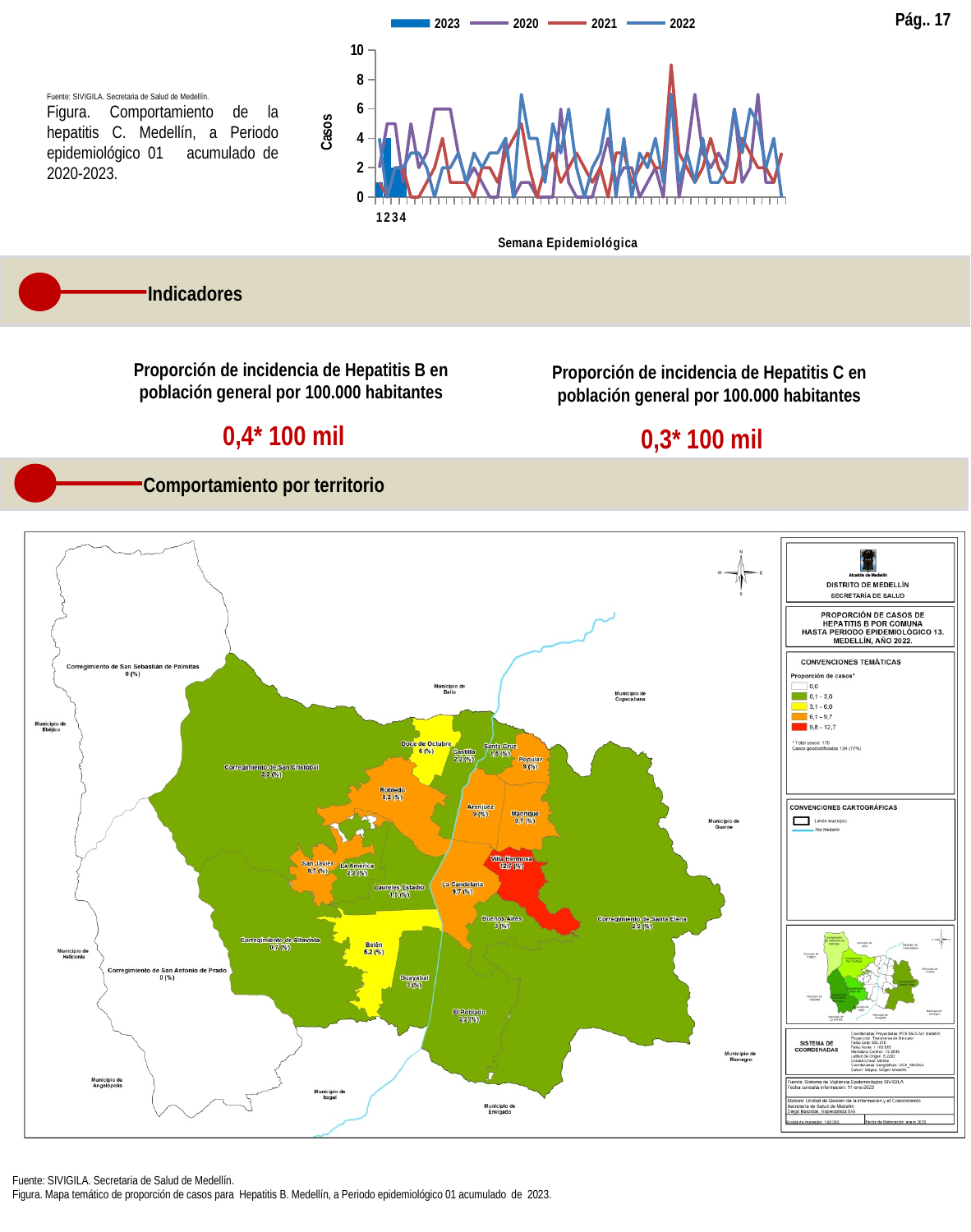
Which years are listed in the legend of the top chart? 2023, 2020, 2021, 2022 What is the label of the vertical axis of the top chart? Casos In the top chart, is the highest peak of the 2020 series greater or less than 8? less In the top chart, is the highest peak of the 2021 series greater or less than 8? greater How many series does the legend of the top chart list? 4 What kind of chart is shown at the top of the slide? combination bar and line chart In the top chart, is the highest peak of the 2022 series greater or less than 8? less In the top chart, which series reaches the highest single-week value? 2021 In the top chart, which series reaches a higher peak, 2021 or 2020? 2021